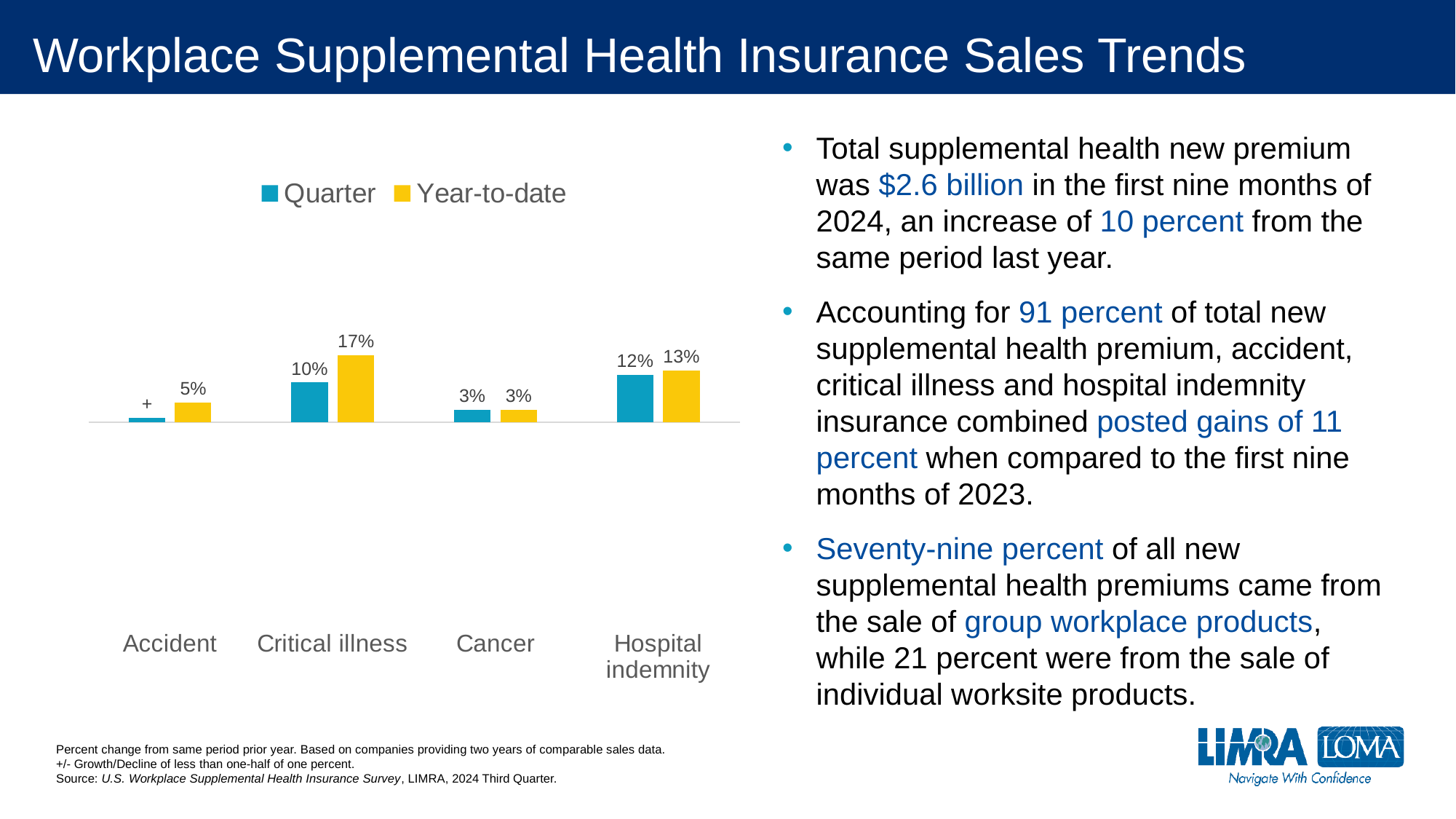
Which colour represents the Year-to-date series in the legend? Yellow How many categories are shown on the x axis? 4 Which category has the lowest Quarter value? Accident Which category has the highest Year-to-date value? Critical illness What is the difference between the Year-to-date and Quarter values for Critical illness? 7% What is the Quarter value for Cancer? 3% What is the Quarter value for Hospital indemnity? 12% What is the Year-to-date value for Accident? 5% How many series does the legend list? 2 What kind of chart is shown on the slide? Bar chart Which is larger for Hospital indemnity, the Quarter value or the Year-to-date value? Year-to-date What is the Year-to-date value for Critical illness? 17%